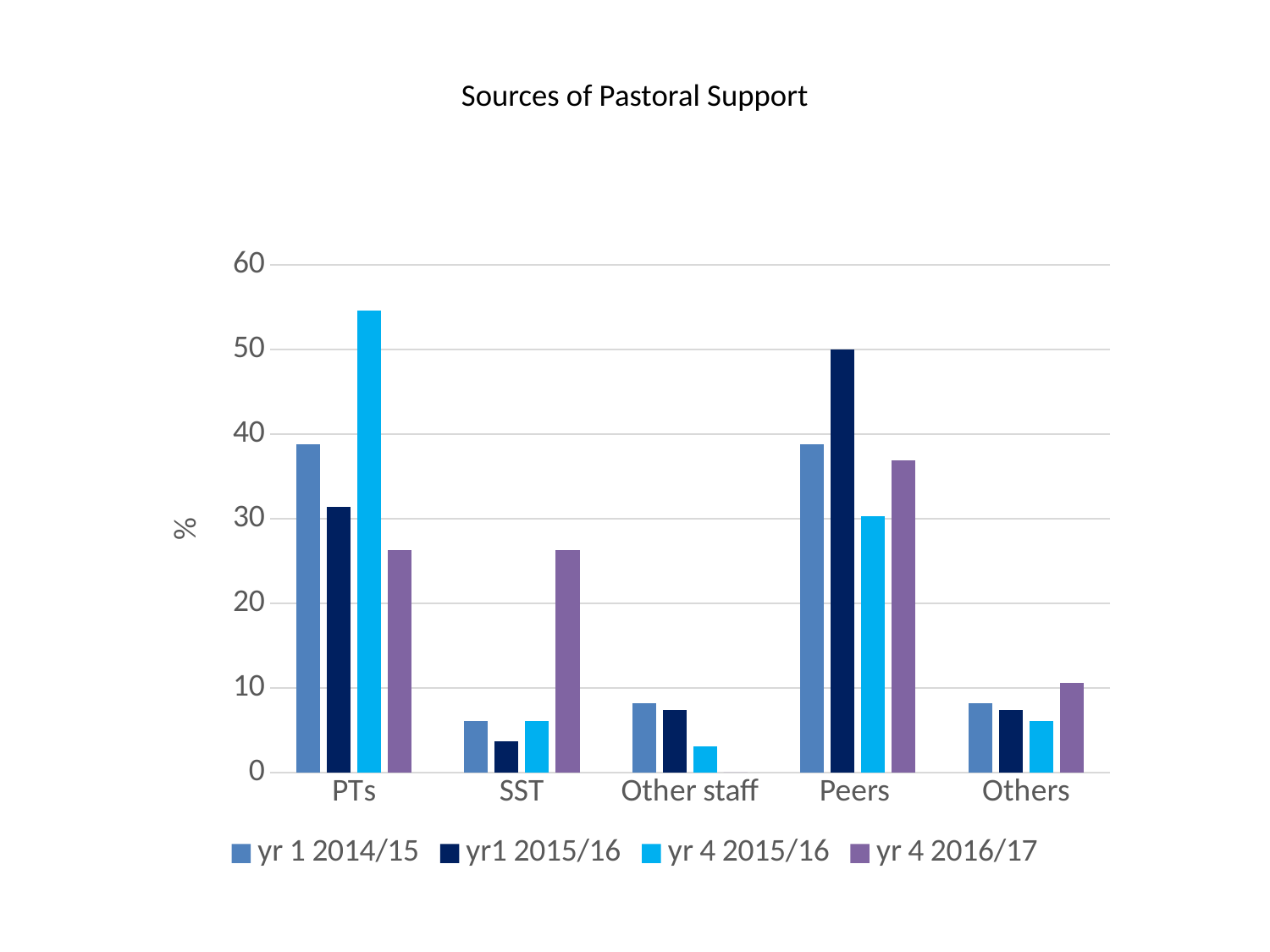
Which category has the highest value for the yr 4 2015/16 series? PTs What kind of chart is shown on the slide? bar chart Is the value for yr 4 2016/17 in the SST category greater or less than 20? greater Is the value for yr 4 2015/16 in the Peers category greater or less than 40? less How many series does the legend list? 4 In the PTs category, which is larger: yr 1 2014/15 or yr1 2015/16? yr 1 2014/15 Is the value for yr 4 2015/16 in the PTs category greater or less than 50? greater Which series has the highest value in the Peers category? yr1 2015/16 What is the title of the chart? Sources of Pastoral Support What is the label on the vertical axis? % How many categories are shown on the x axis of the chart? 5